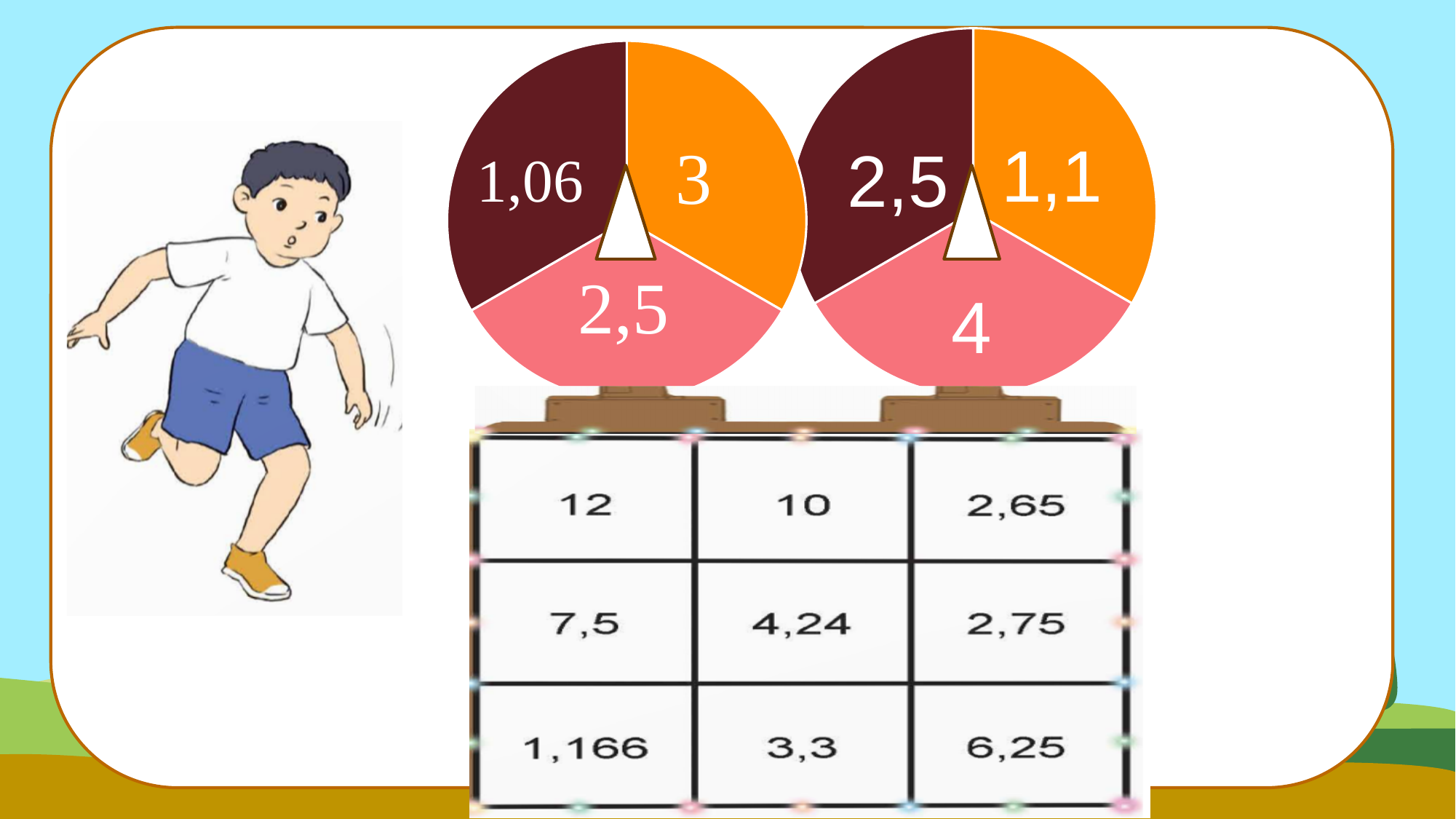
On the right spinner, which sector has the largest number written on it? the pink sector (4) What colour is the sector labelled 4 on the right spinner? pink On the left spinner, what number is written on the pink sector? 2,5 On the right spinner, what number is written on the dark red sector? 2,5 On the right spinner, what number is written on the pink sector? 4 On the left spinner, which sector has the smallest number written on it? the dark red sector (1,06) On the left spinner, what number is written on the dark red sector? 1,06 On the left spinner, what number is written on the orange sector? 3 On the right spinner, what number is written on the orange sector? 1,1 How many sectors does the right spinner have? 3 How many spinners are shown on the slide? 2 How many sectors does the left spinner have? 3